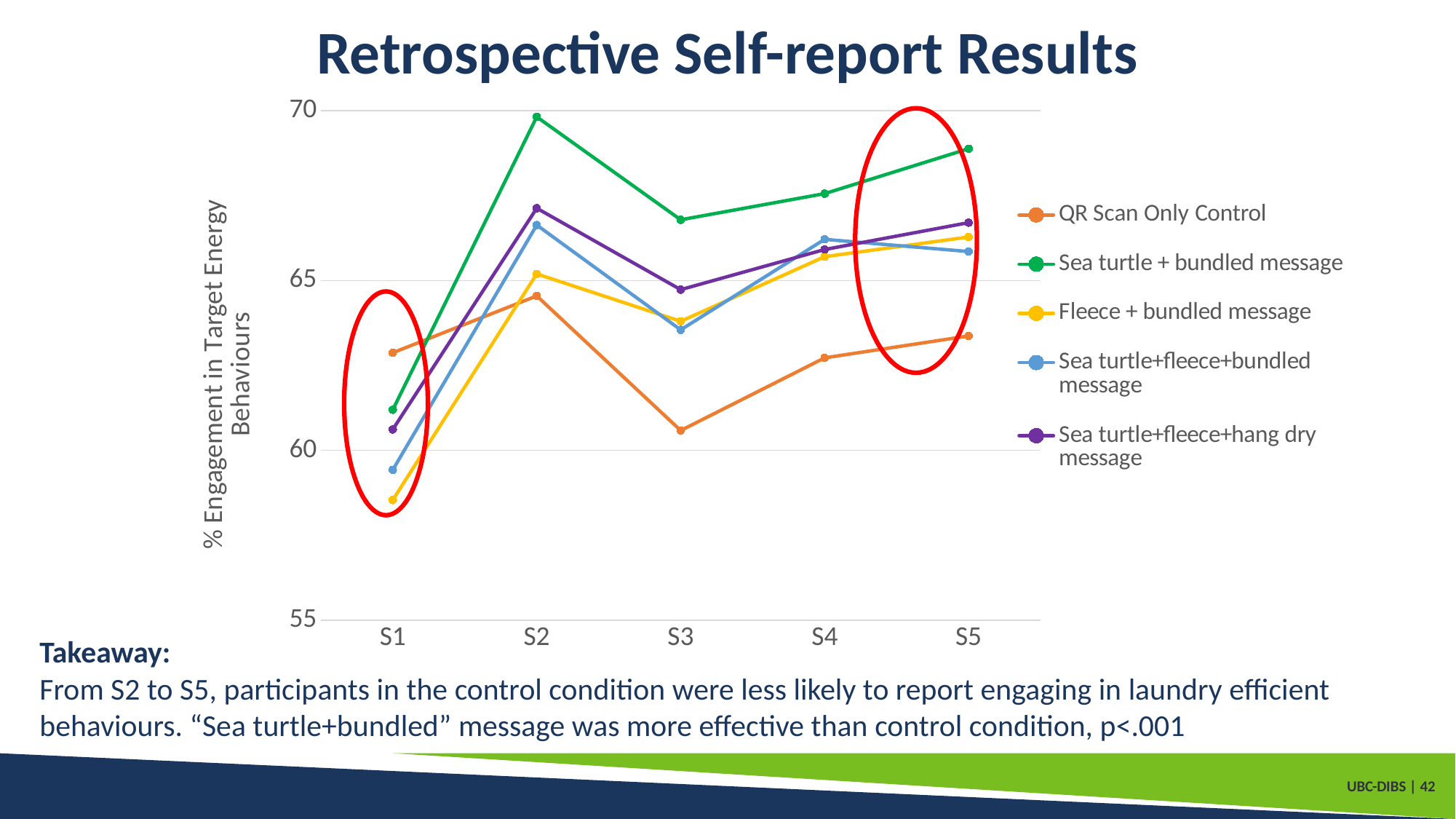
What kind of chart is shown on the slide? Line chart Is the value for Fleece + bundled message at S1 greater or less than 60? less At S5, which is larger: Sea turtle + bundled message or QR Scan Only Control? Sea turtle + bundled message Does the QR Scan Only Control line rise or fall from S3 to S5? Rises Which series has the highest value at S2? Sea turtle + bundled message Is the value for Sea turtle + bundled message at S2 greater or less than 65? greater How many points are on the x axis of the chart? 5 Which series has the lowest value at S1? Fleece + bundled message How many series does the legend list? 5 What is the label on the y axis of the chart? % Engagement in Target Energy Behaviours Is the value for QR Scan Only Control at S3 greater or less than 65? less Which series has the lowest value at S3? QR Scan Only Control